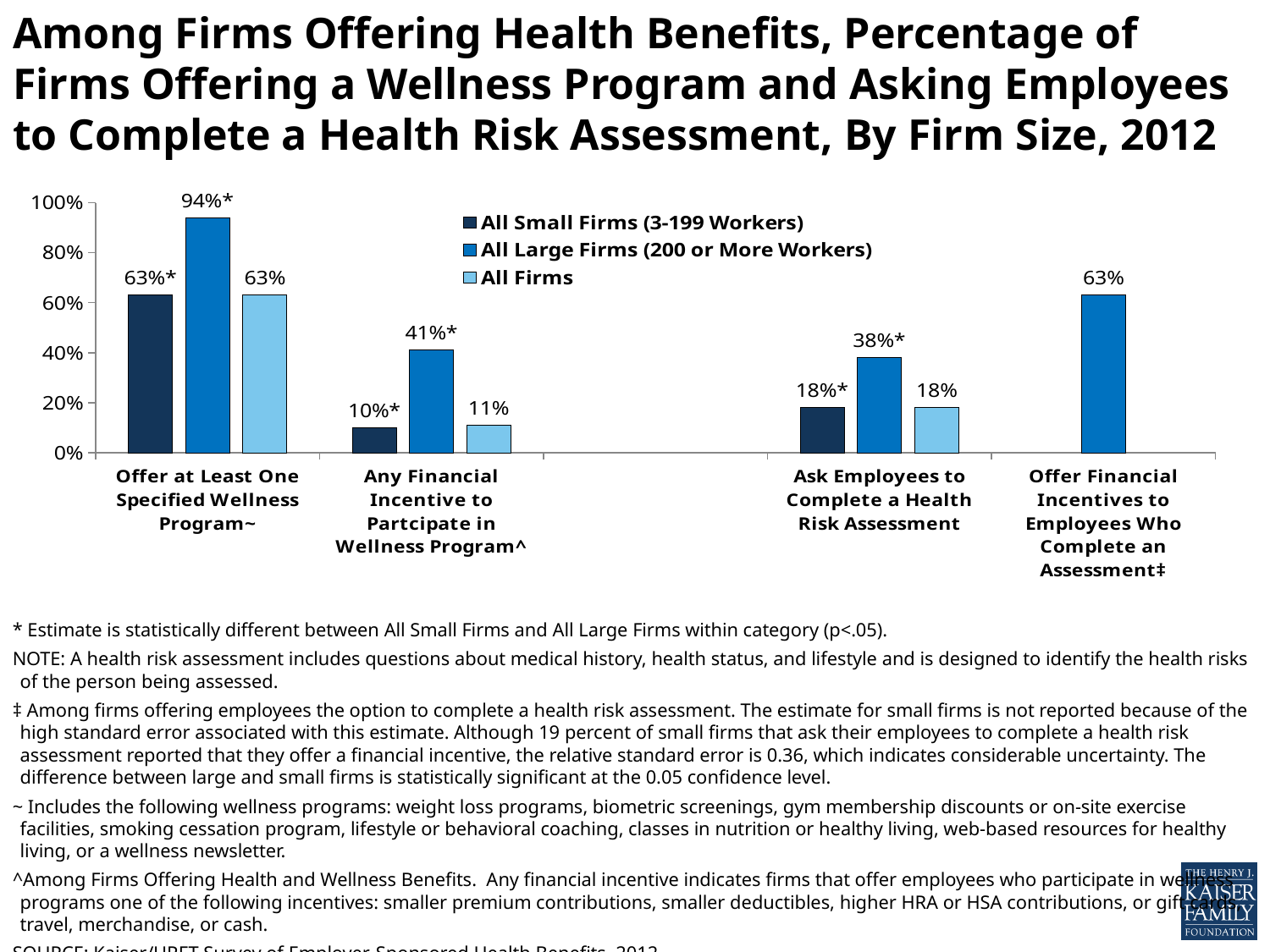
What is the difference between All Large Firms and All Small Firms in the 'Ask Employees to Complete a Health Risk Assessment' category? 20% Which category has the highest value for All Large Firms (200 or More Workers)? Offer at Least One Specified Wellness Program~ How many categories are shown on the x axis? 4 How many series does the legend list? 3 Which series is shown in the lightest blue colour in the legend? All Firms What percentage of All Large Firms (200 or More Workers) offer at least one specified wellness program? 94% What is the value for All Firms in the 'Ask Employees to Complete a Health Risk Assessment' category? 18% What kind of chart is shown on the slide? Bar chart In the 'Any Financial Incentive to Partcipate in Wellness Program^' category, which is larger: All Large Firms or All Firms? All Large Firms What percentage of All Large Firms offer financial incentives to employees who complete an assessment? 63% What percentage of All Small Firms (3-199 Workers) offer any financial incentive to participate in a wellness program? 10% Which category has the lowest value for All Small Firms (3-199 Workers)? Any Financial Incentive to Partcipate in Wellness Program^